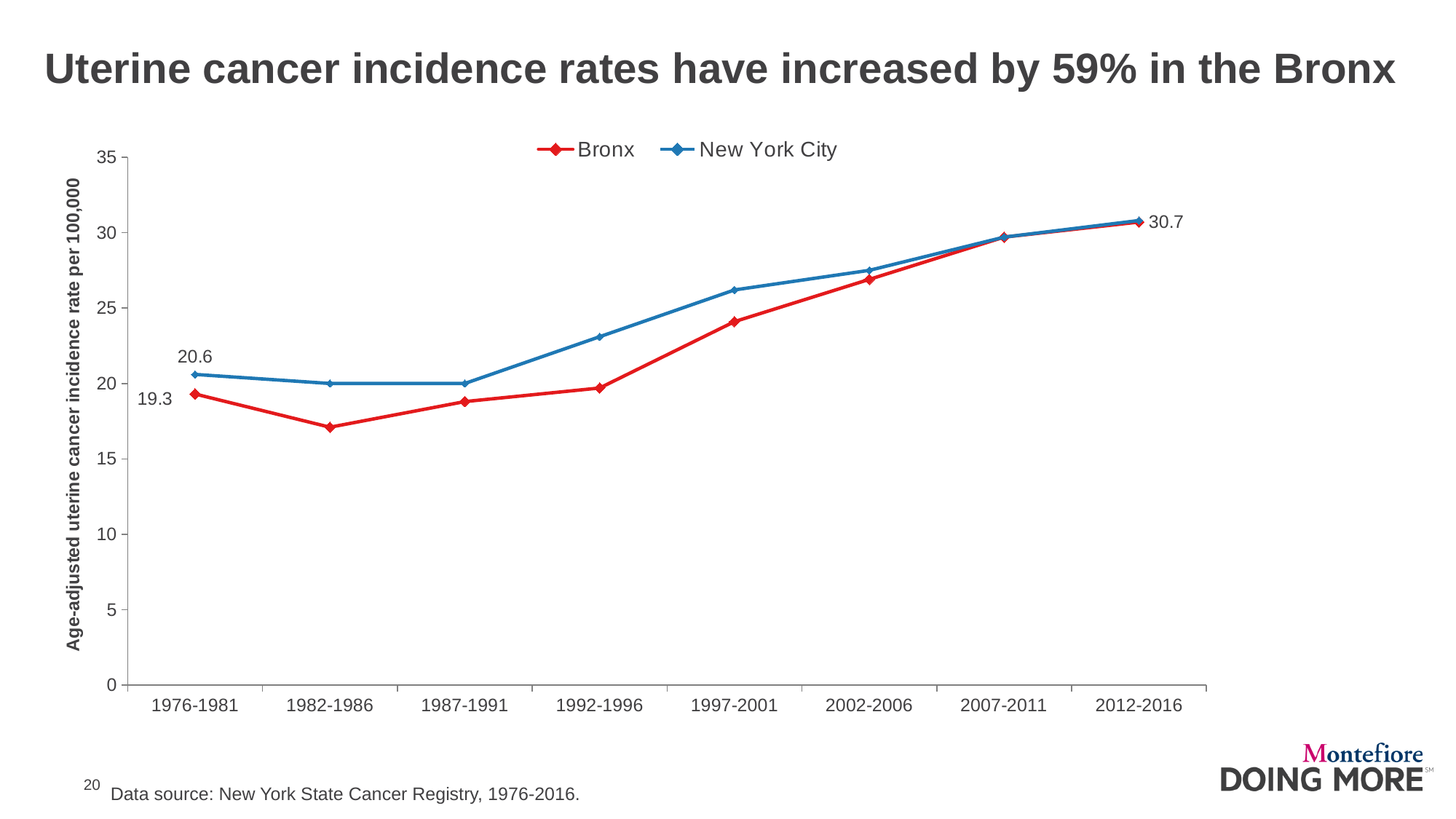
How many series does the legend list? 2 What is the difference between the New York City and Bronx rates in 1976-1981? 1.3 How many time periods are shown on the x axis? 8 In 1976-1981, which had the higher rate, Bronx or New York City? New York City Is the New York City value for 1997-2001 greater or less than 25? greater What is the New York City uterine cancer incidence rate for 1976-1981? 20.6 By how much did the Bronx rate increase from 1976-1981 to 2012-2016? 11.4 What type of chart is shown on the slide? line chart In which period is the Bronx rate lowest? 1982-1986 What is the Bronx uterine cancer incidence rate for 1976-1981? 19.3 What is the Bronx uterine cancer incidence rate for 2012-2016? 30.7 Is the Bronx value for 1982-1986 greater or less than 20? less